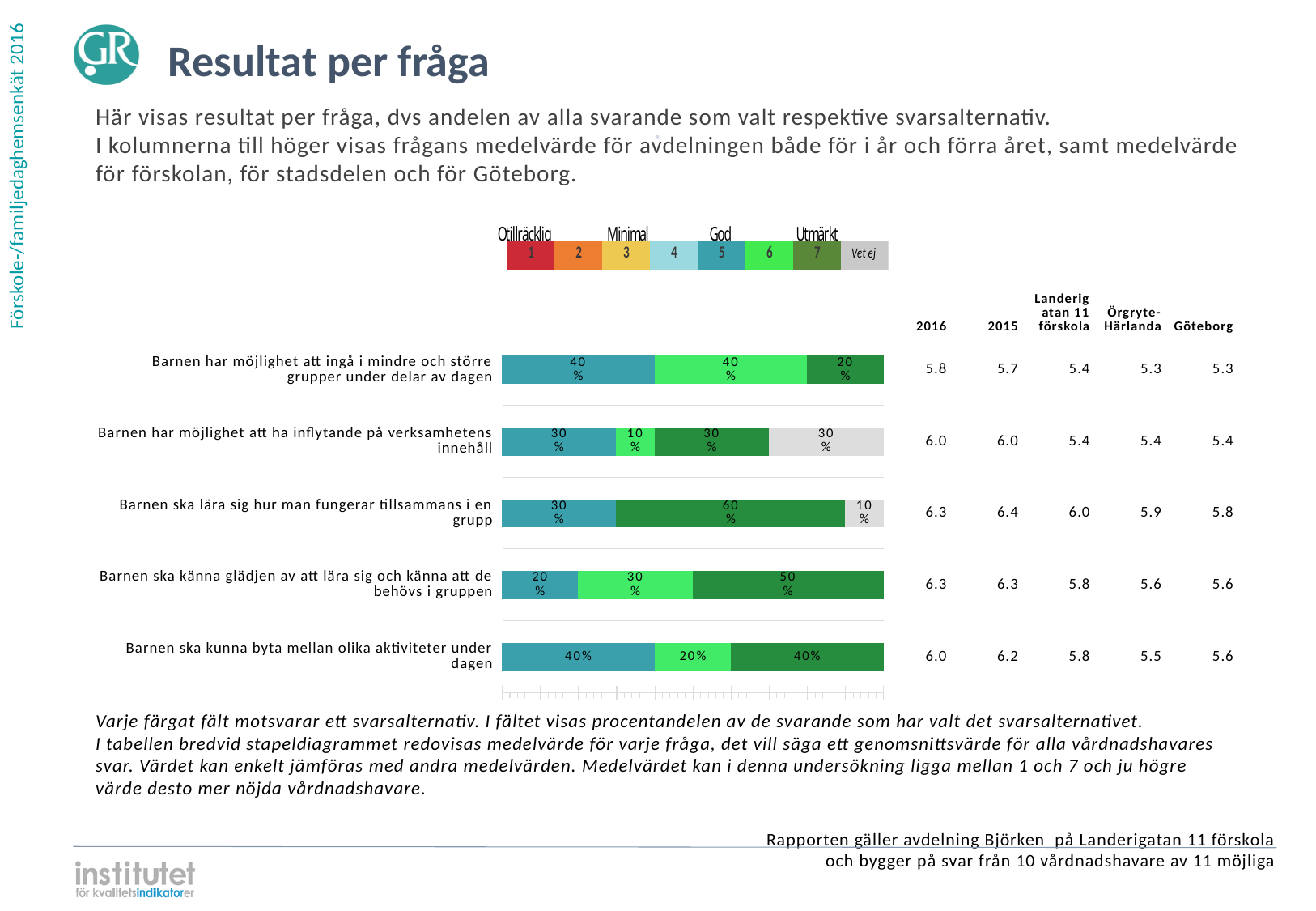
What percentage chose answer 5 (teal) for "Barnen ska kunna byta mellan olika aktiviteter under dagen"? 40% What kind of chart is used to show the results per question? Stacked bar chart What is the 2016 mean value for "Barnen har möjlighet att ingå i mindre och större grupper under delar av dagen"? 5.8 For "Barnen ska kunna byta mellan olika aktiviteter under dagen", which is higher: the 2016 mean or the 2015 mean? 2015 Which question has the largest share of respondents choosing answer 7 (dark green)? Barnen ska lära sig hur man fungerar tillsammans i en grupp How many answer alternatives does the legend above the chart list, including "Vet ej"? 8 Which answer alternative is shown in grey in the legend? Vet ej What is the Göteborg mean value for "Barnen ska lära sig hur man fungerar tillsammans i en grupp"? 5.8 What is the difference between the share choosing answer 7 and the share choosing answer 5 for "Barnen ska känna glädjen av att lära sig och känna att de behövs i gruppen"? 30% What percentage of respondents chose answer 7 (dark green) for "Barnen ska lära sig hur man fungerar tillsammans i en grupp"? 60% What percentage of respondents answered "Vet ej" for "Barnen har möjlighet att ha inflytande på verksamhetens innehåll"? 30% How many questions (categories) are shown in the bar chart? 5